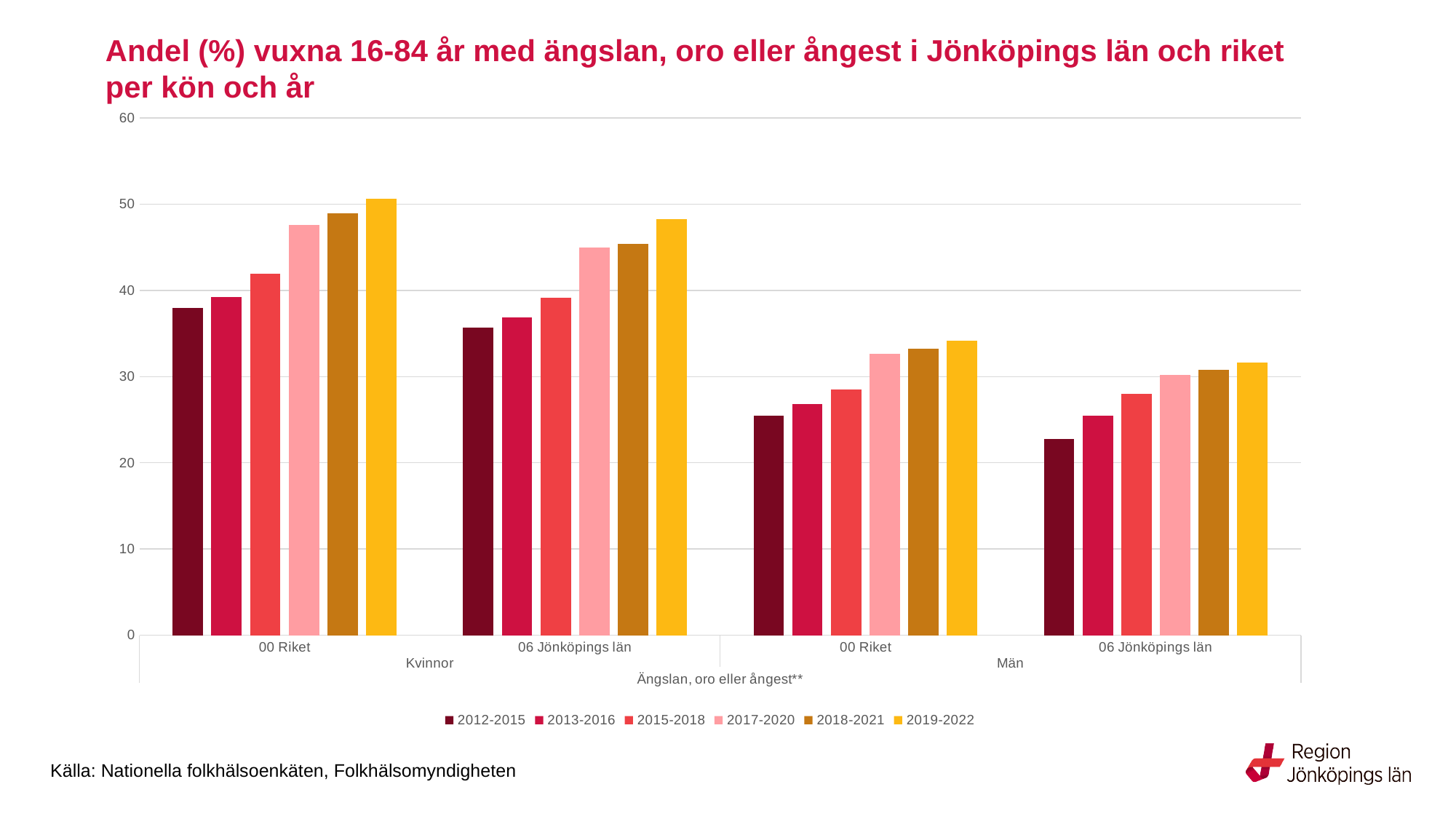
Is the 2019-2022 value for Kvinnor, 06 Jönköpings län greater or less than 50? less Which bar is the lowest in the whole chart? 2012-2015 for Män, 06 Jönköpings län What kind of chart is shown on the slide? bar chart Within each group, do the values rise or fall from 2012-2015 to 2019-2022? rise Is the 2012-2015 value for Kvinnor, 00 Riket greater or less than 40? less For 2019-2022 among Kvinnor, which is larger: 00 Riket or 06 Jönköpings län? 00 Riket Is the 2012-2015 value for Män, 00 Riket greater or less than 30? less Which bar is the highest in the whole chart? 2019-2022 for Kvinnor, 00 Riket How many series does the legend list? 6 How many category groups of bars are shown along the x axis? 4 What is the source given at the bottom of the slide? Nationella folkhälsoenkäten, Folkhälsomyndigheten